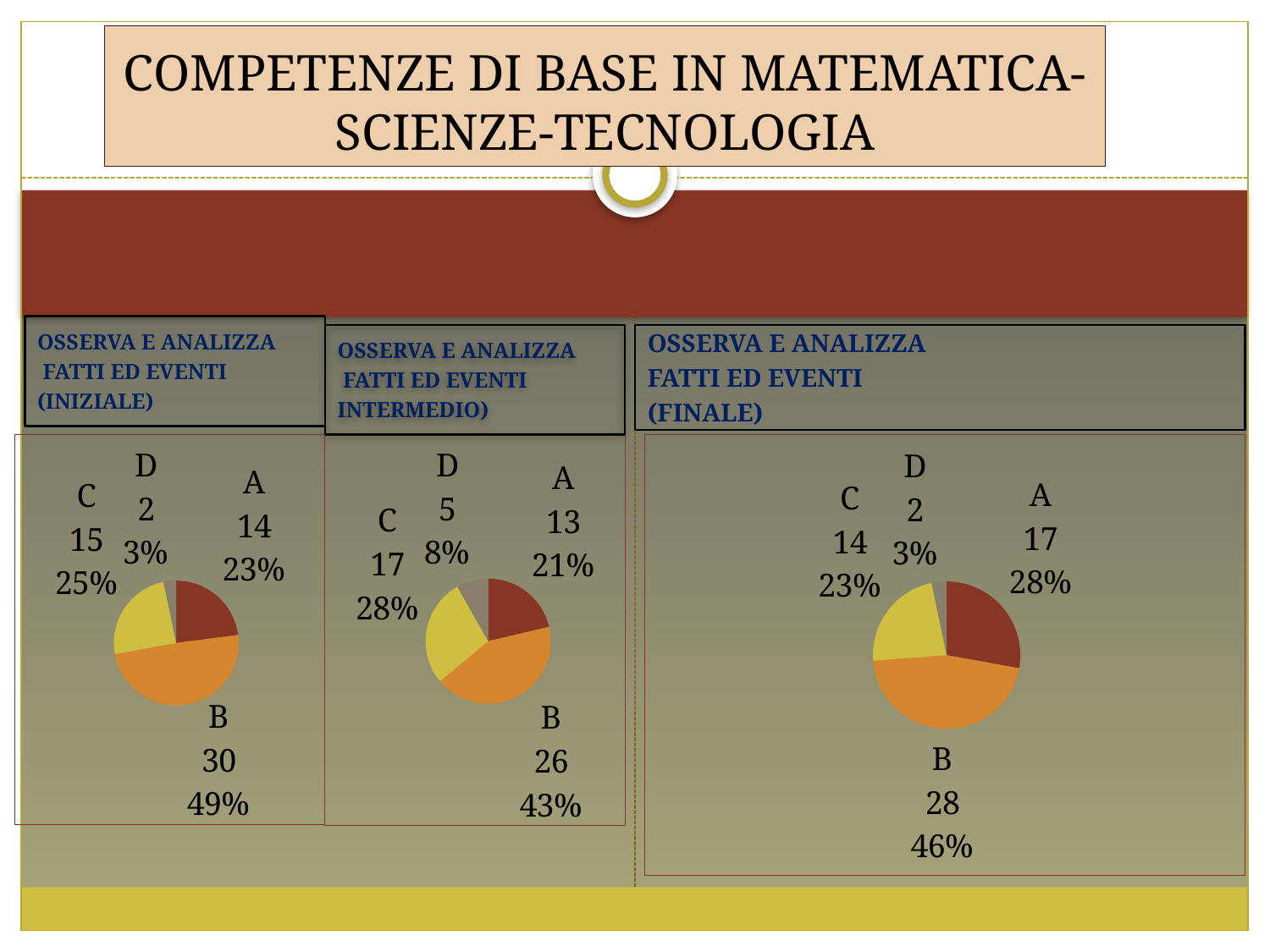
In the INTERMEDIO pie chart, what is the value for category D? 5 In the INTERMEDIO pie chart, what share of the pie does category B represent? 43% In the INIZIALE pie chart, what is the value for category B? 30 In the FINALE pie chart, which is larger, the value for A or the value for C? A What type of chart is used in the FINALE panel? Pie chart In the INIZIALE pie chart, what share of the pie does category C represent? 25% How many categories does the INTERMEDIO pie chart show? 4 In the FINALE pie chart, what share of the pie does category C represent? 23% In the INIZIALE pie chart, what is the difference between the values for B and A? 16 In the FINALE pie chart, what is the value for category A? 17 In the FINALE pie chart, which category has the largest value? B In the INTERMEDIO pie chart, which category has the smallest value? D